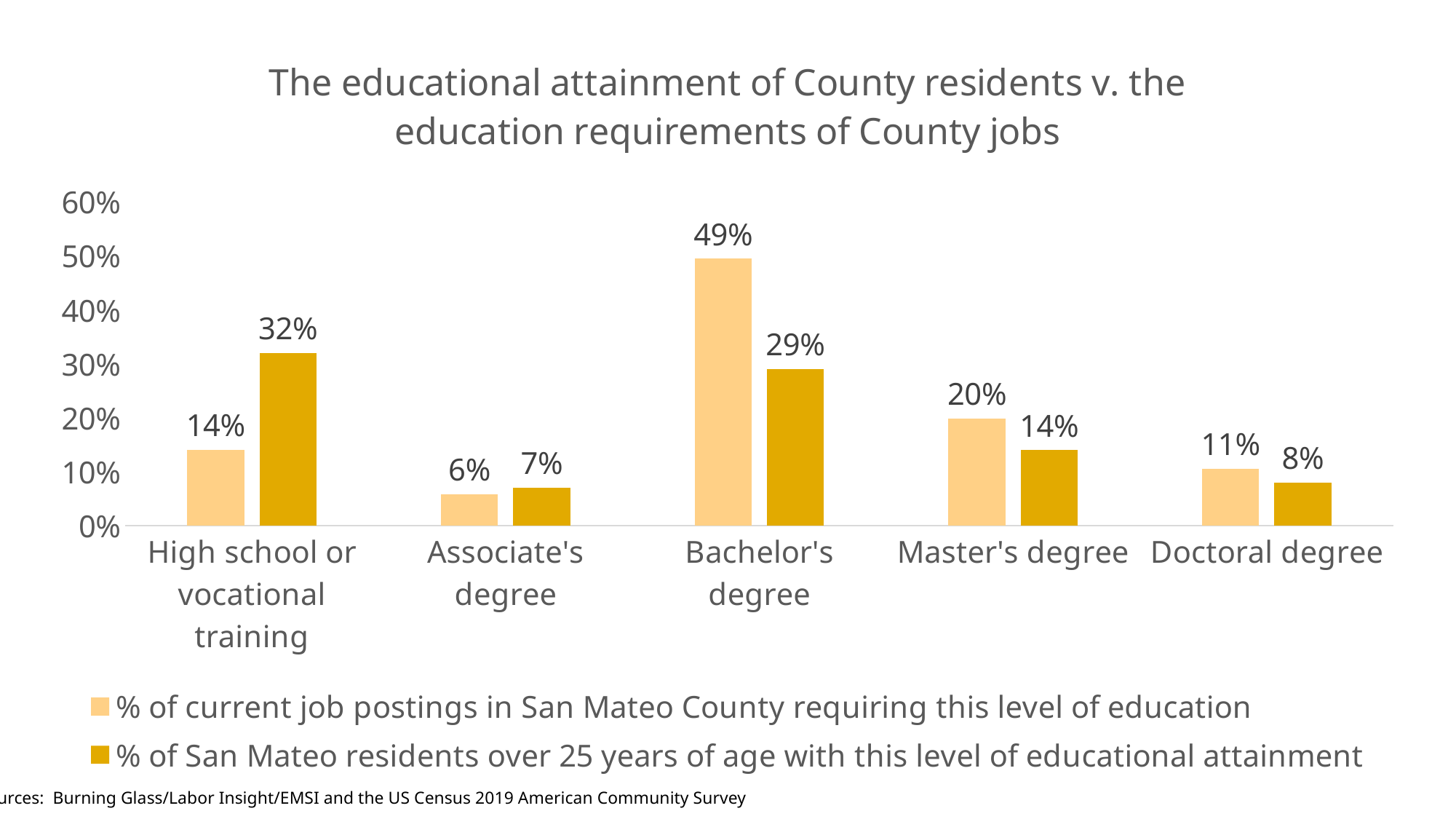
What is the title of the chart? The educational attainment of County residents v. the education requirements of County jobs What percentage of San Mateo residents over 25 have a high school or vocational training level of educational attainment? 32% For Master's degree, which is larger: the share of job postings requiring it or the share of residents with it? % of current job postings in San Mateo County requiring this level of education What is the difference between the share of residents with high school or vocational training and the share of job postings requiring it? 18% What percentage of San Mateo residents over 25 have a Doctoral degree? 8% How many series does the legend list? 2 What percentage of current job postings in San Mateo County require a Bachelor's degree? 49% Which education level has the lowest share of San Mateo residents over 25 with that attainment? Associate's degree Which education level has the highest share of current job postings requiring it? Bachelor's degree What kind of chart is shown on the slide? Bar chart How many education levels are shown on the x axis? 5 What is the difference between the share of job postings requiring a Bachelor's degree and the share of residents with a Bachelor's degree? 20%